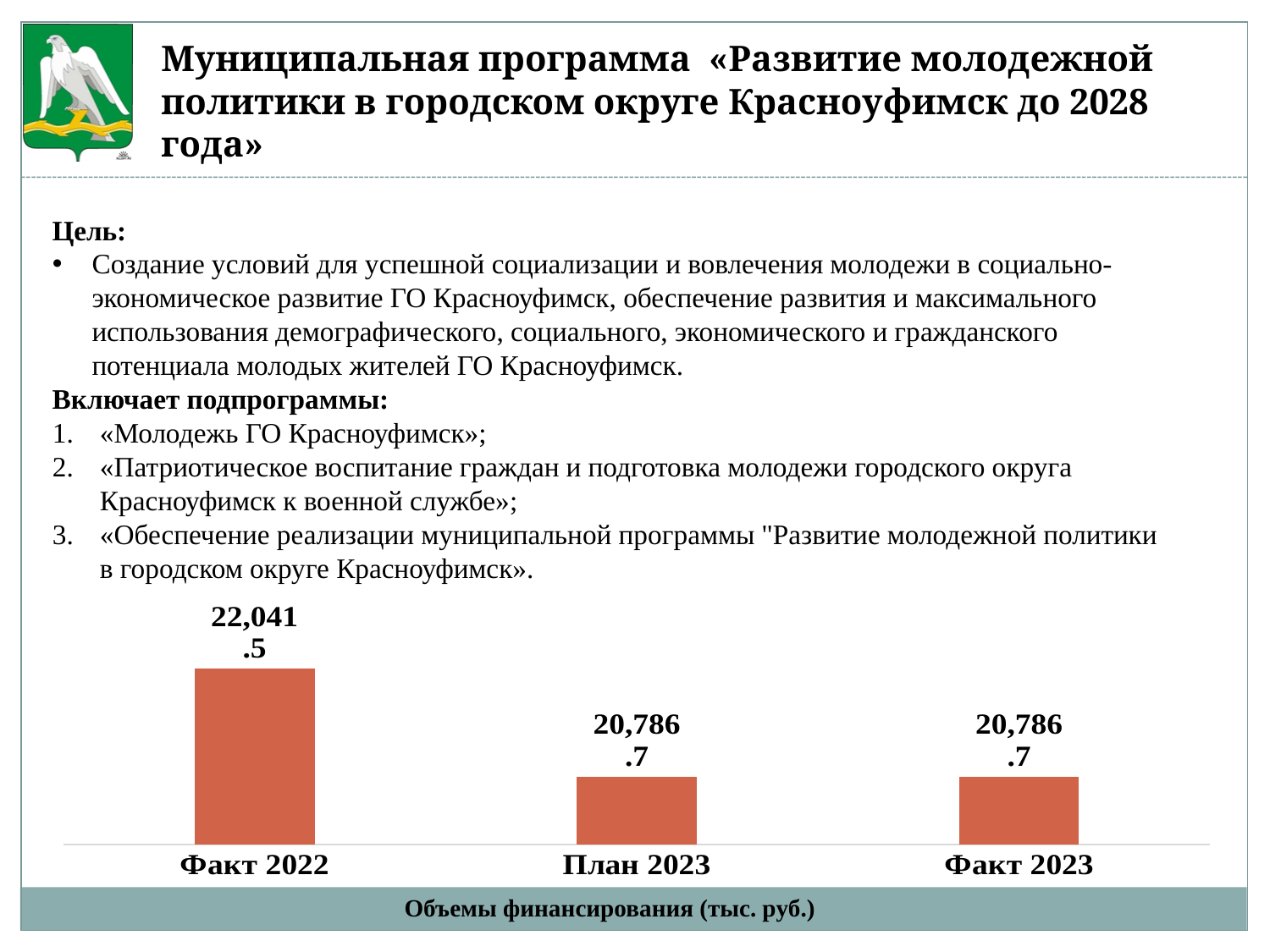
Is the value for План 2023 larger than, smaller than, or equal to the value for Факт 2023? equal What is the difference between the values for Факт 2022 and Факт 2023? 1,254.8 Which category has the highest value in the chart? Факт 2022 What is the value for Факт 2023 in the chart? 20,786.7 What is the value for Факт 2022 in the chart? 22,041.5 Do the values rise or fall from Факт 2022 to План 2023? fall Which is larger, the value for Факт 2022 or the value for План 2023? Факт 2022 What kind of chart is shown on the slide? bar chart What is the value for План 2023 in the chart? 20,786.7 What is the title of the chart? Объемы финансирования (тыс. руб.) How many categories are shown in the chart? 3 What is the difference between the values for Факт 2022 and План 2023? 1,254.8